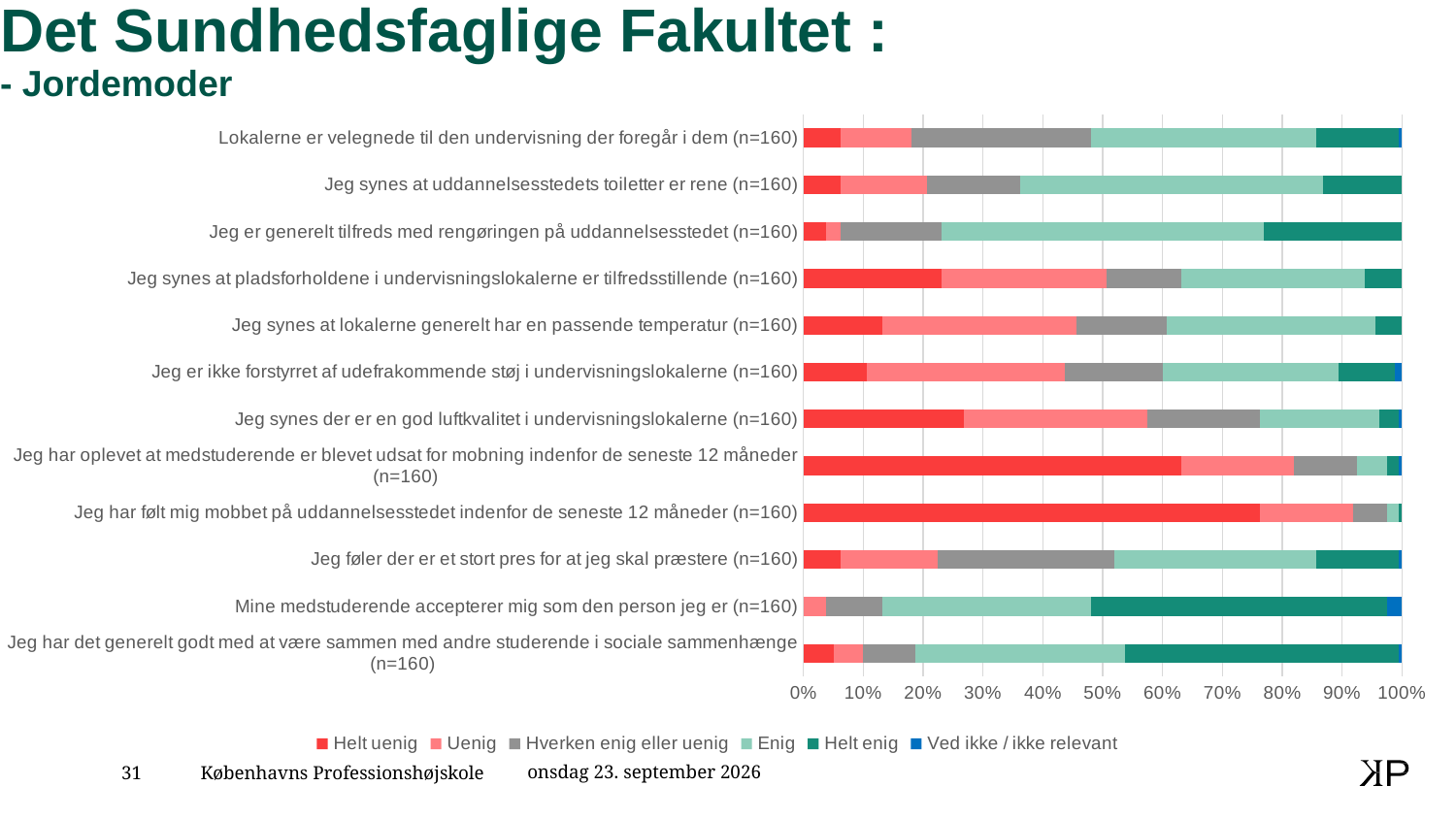
Which legend entry is shown in dark green? Helt enig Is the 'Helt uenig' share for 'Jeg synes der er en god luftkvalitet i undervisningslokalerne' greater or less than 20%? greater What is the n value shown for each statement in the chart? n=160 What kind of chart is shown on the slide? Stacked bar chart Is the 'Helt uenig' share for 'Jeg har følt mig mobbet på uddannelsesstedet indenfor de seneste 12 måneder' greater or less than 70%? greater How many series does the legend list? 6 How many statements (categories) are plotted in the chart? 12 Which statement has the largest 'Helt uenig' segment? Jeg har følt mig mobbet på uddannelsesstedet indenfor de seneste 12 måneder (n=160) Which statement has the smallest 'Helt uenig' segment? Mine medstuderende accepterer mig som den person jeg er (n=160) Is the 'Helt uenig' share for 'Jeg synes at pladsforholdene i undervisningslokalerne er tilfredsstillende' greater or less than 30%? less Which has the larger 'Helt uenig' segment: 'Jeg synes der er en god luftkvalitet i undervisningslokalerne' or 'Jeg synes at lokalerne generelt har en passende temperatur'? Jeg synes der er en god luftkvalitet i undervisningslokalerne